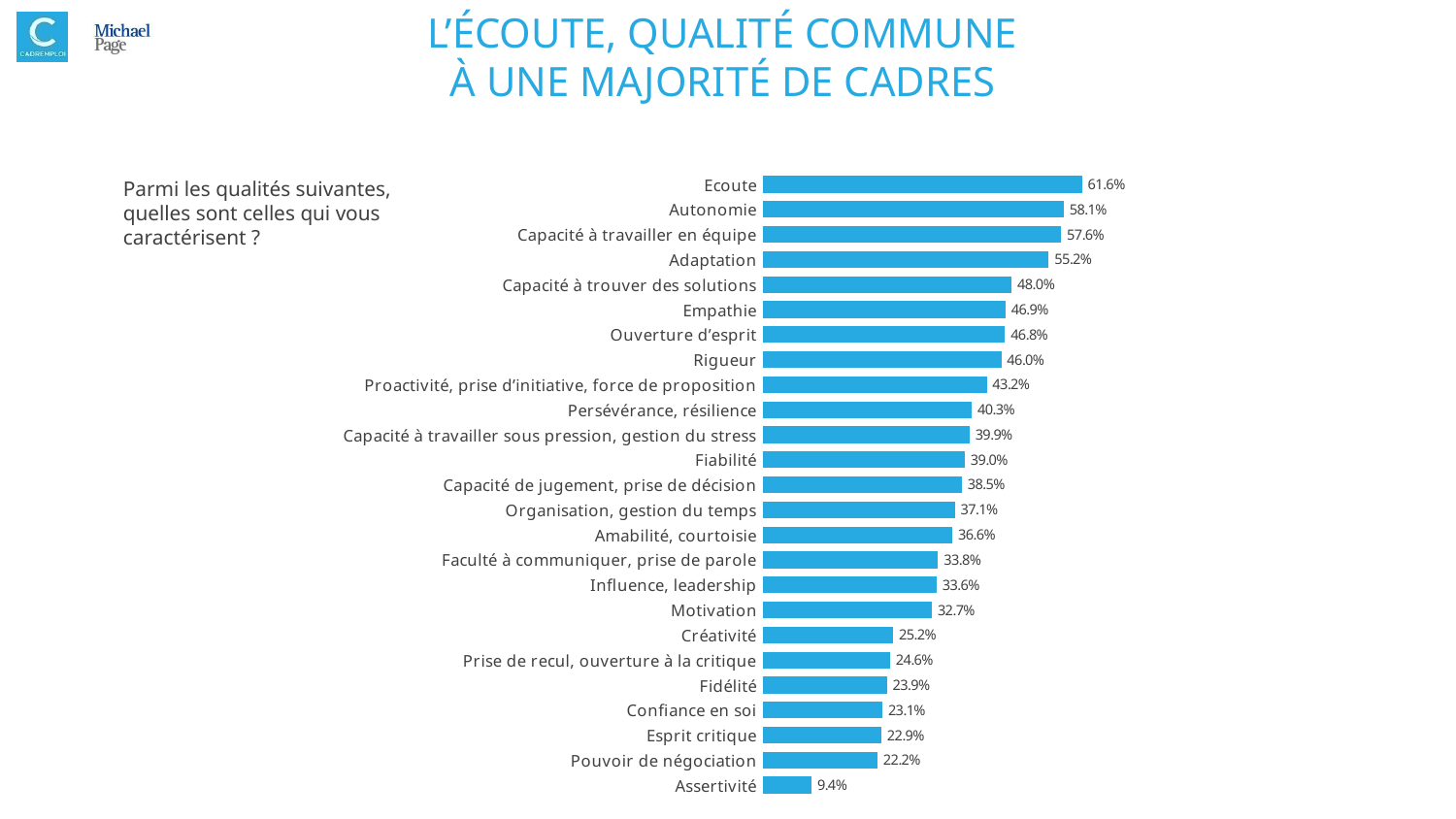
What question is the chart answering, as written on the left of the slide? Parmi les qualités suivantes, quelles sont celles qui vous caractérisent ? How many qualities are shown in the chart? 25 What is the value for Motivation? 32.7% What is the value for Pouvoir de négociation? 22.2% What is the value for Rigueur? 46.0% Which quality has the lowest value? Assertivité Which is larger, the value for Empathie or the value for Créativité? Empathie Which quality has the highest value? Ecoute What is the difference between the values for Adaptation and Assertivité? 45.8% What kind of chart is shown on the slide? Bar chart What is the value for Ecoute? 61.6% What is the difference between the values for Ecoute and Autonomie? 3.5%